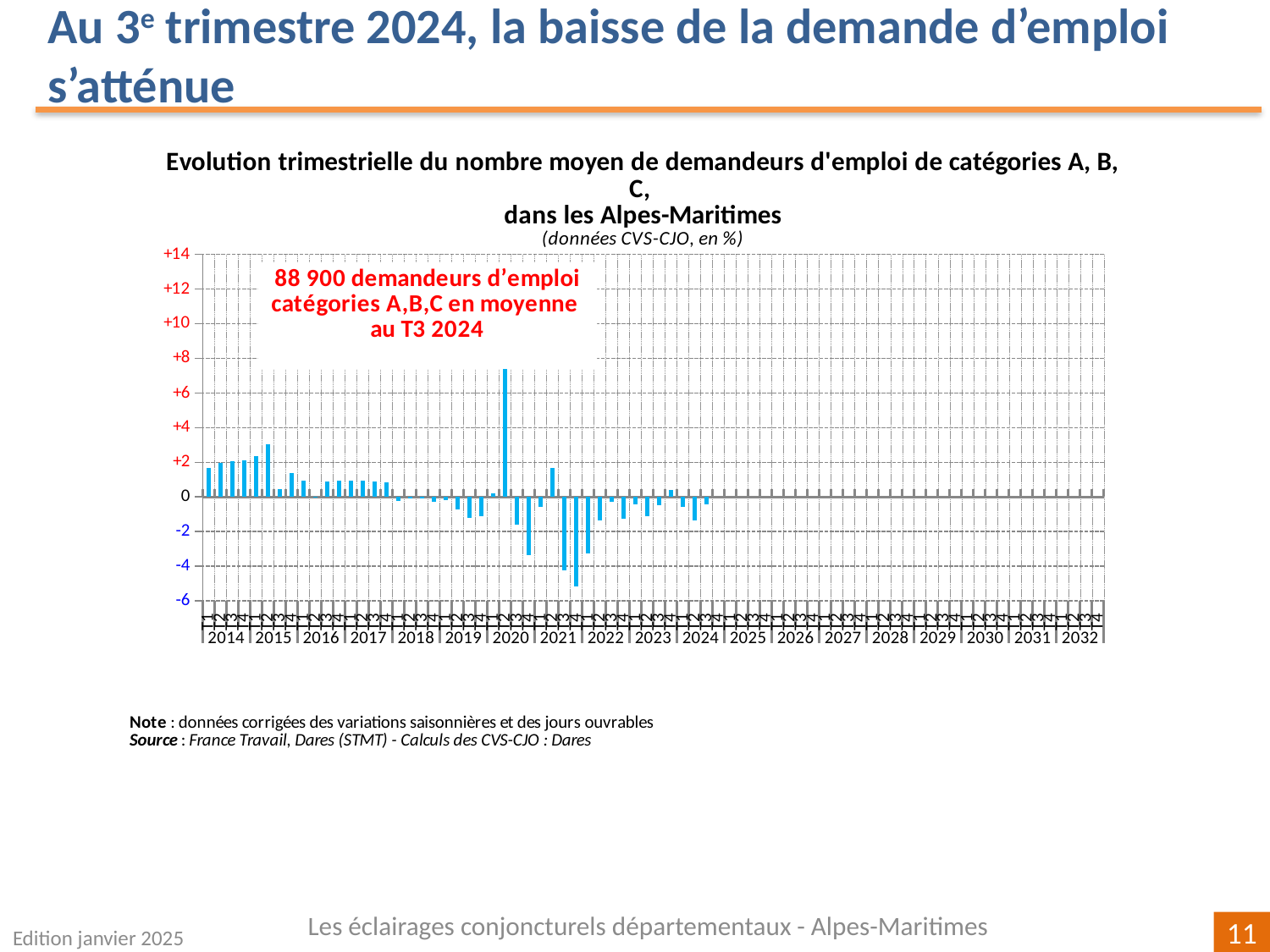
How many years are labelled on the horizontal axis of the chart? 19 In which year does the tallest (highest) bar of the chart occur? 2020 What is the highest value shown on the vertical axis? +14 According to the text box on the chart, how many job seekers in categories A, B, C were there on average in T3 2024? 88 900 Is the value of the tallest bar in 2020 greater or less than +6? greater Are the bars in 2014 mostly positive or negative? Positive What kind of chart is shown on the slide? Bar chart In which year does the lowest (most negative) bar of the chart occur? 2021 Which is larger: the tallest bar in 2020 or the tallest bar in 2015? The tallest bar in 2020 Is the value of the tallest bar in 2015 greater or less than +2? greater Is the value of the lowest bar in 2021 greater or less than -4? less